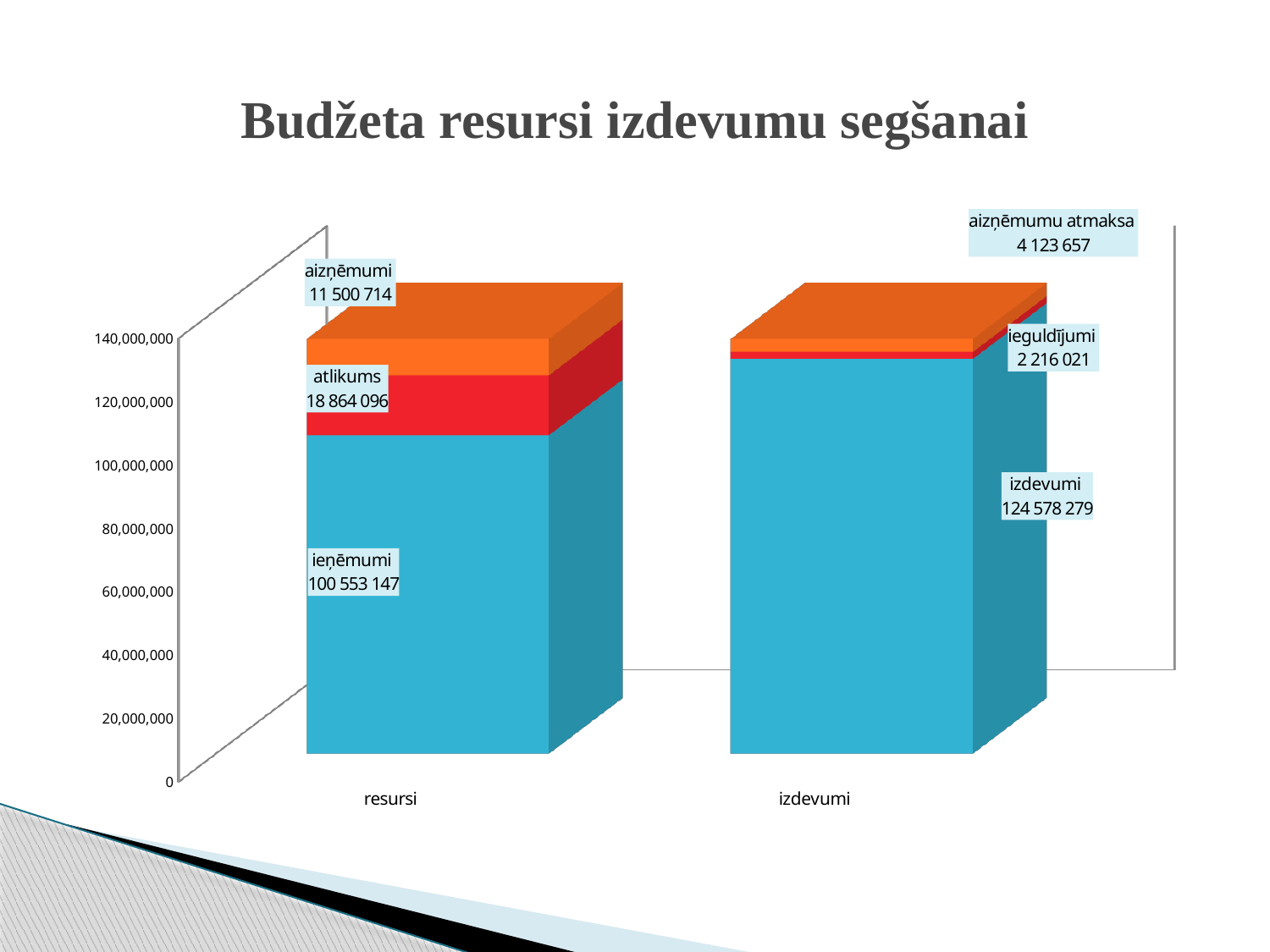
What is the value of the ieņēmumi segment in the resursi bar? 100 553 147 Which labelled segment has the largest value on the chart? izdevumi (124 578 279) What is the value of the izdevumi segment in the izdevumi bar? 124 578 279 Which labelled segment has the smallest value on the chart? ieguldījumi (2 216 021) What is the value of the aizņēmumu atmaksa segment? 4 123 657 What is the difference between the izdevumi segment and the ieņēmumi segment? 24 025 132 What is the total of the resursi stacked bar? 130 917 957 Which is larger, the atlikums segment or the aizņēmumi segment? atlikums What is the title of the slide? Budžeta resursi izdevumu segšanai What is the value of the atlikums segment in the resursi bar? 18 864 096 What is the value of the aizņēmumi segment in the resursi bar? 11 500 714 What is the value of the ieguldījumi segment? 2 216 021